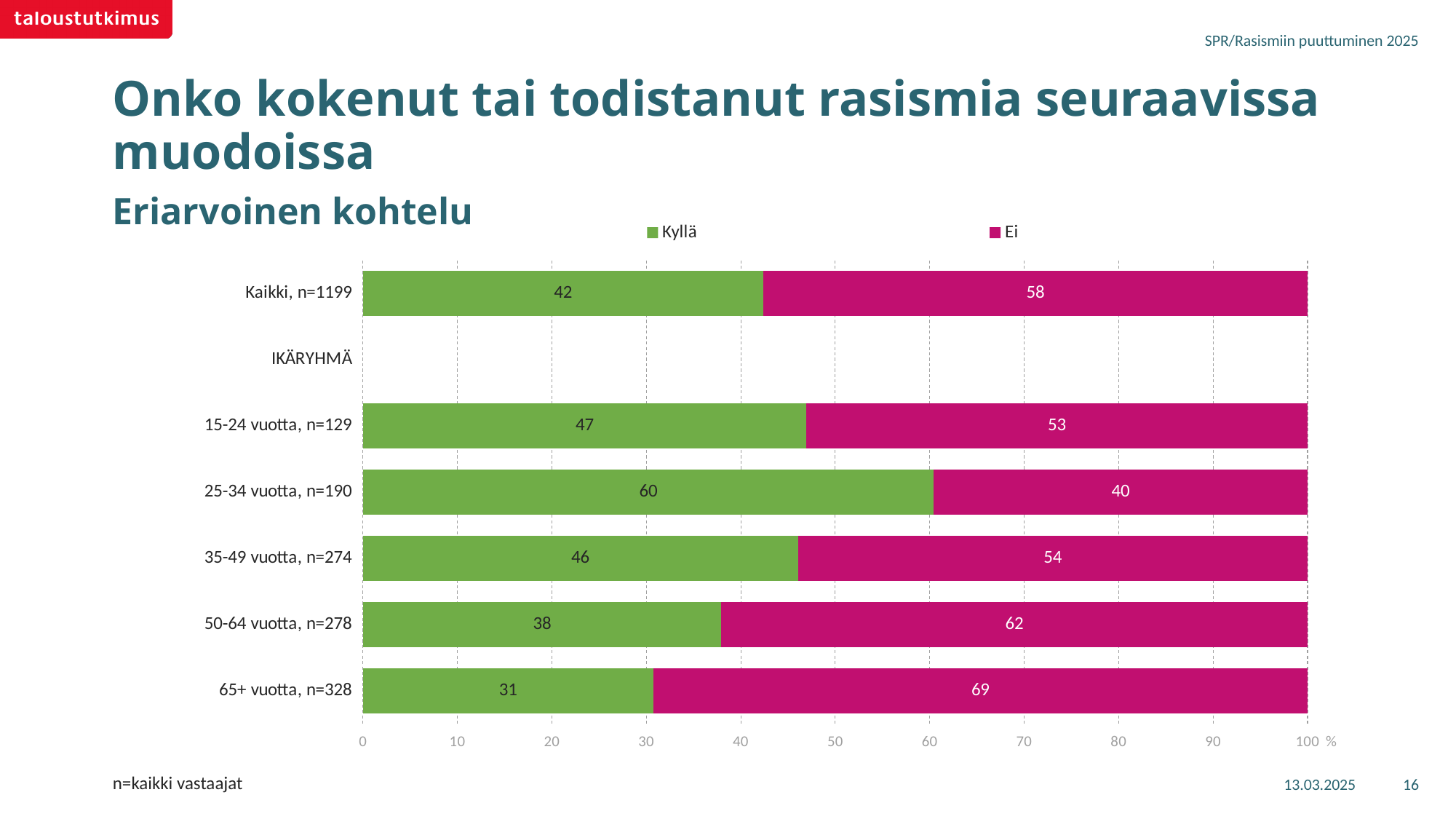
What kind of chart is shown on the slide? Stacked bar chart What is the difference between the Ei value and the Kyllä value for 50-64 vuotta, n=278? 24 What is the total of the stacked bar for 35-49 vuotta, n=274? 100 What is the Ei value for 65+ vuotta, n=328? 69 Which age group has the highest Kyllä value? 25-34 vuotta, n=190 How many series does the legend list? 2 What colour represents the Ei series in the chart? Magenta/pink How many bars with data are plotted in the chart? 6 What is the Kyllä value for Kaikki, n=1199? 42 Which is larger for 15-24 vuotta, n=129: the Kyllä value or the Ei value? Ei What is the Kyllä value for 25-34 vuotta, n=190? 60 Which age group has the lowest Kyllä value? 65+ vuotta, n=328